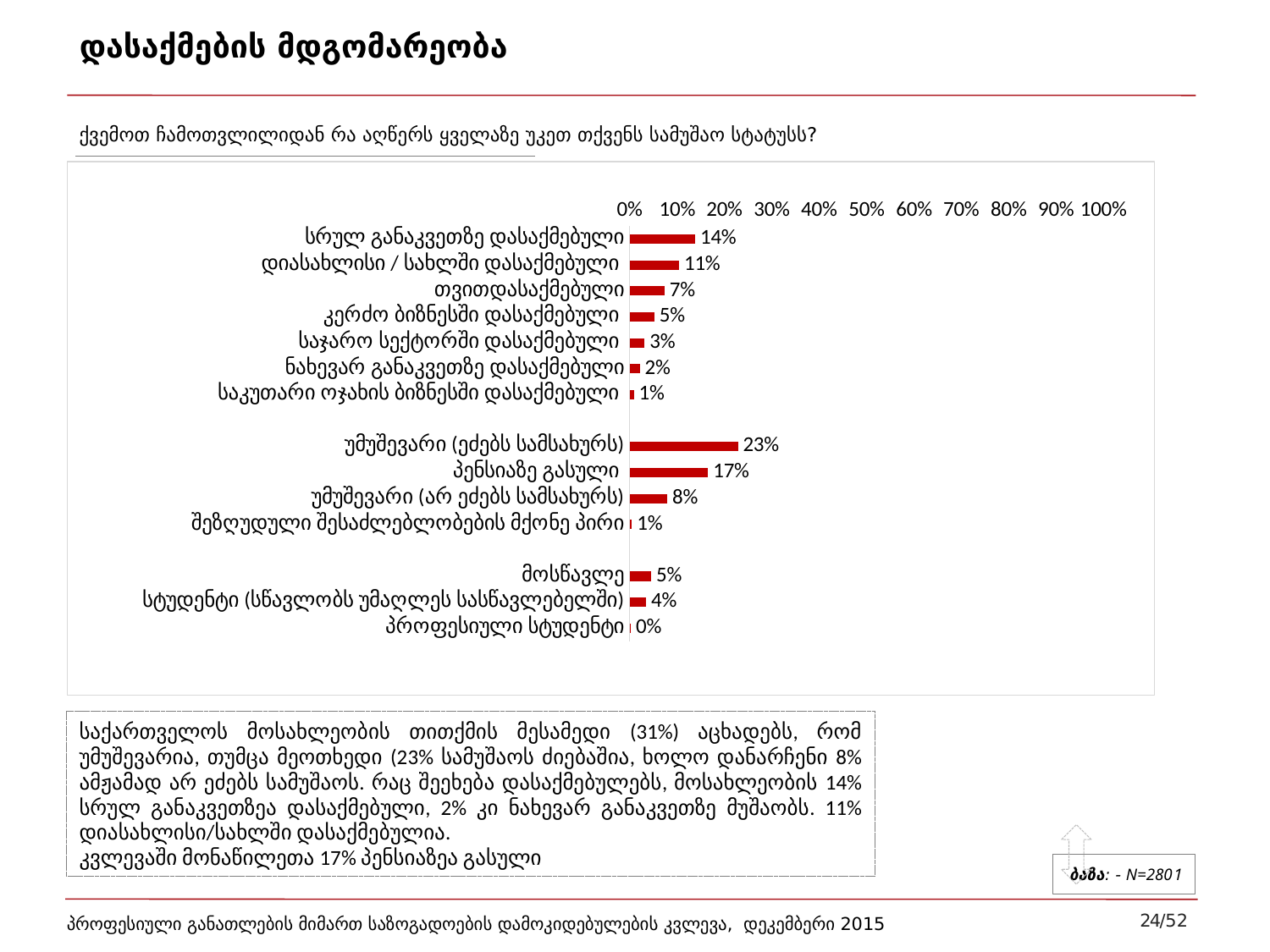
Is the value for პენსიაზე გასული greater or less than 20%? less Which category has the highest value? უმუშევარი (ეძებს სამსახურს) What is the difference between სრულ განაკვეთზე დასაქმებული and ნახევარ განაკვეთზე დასაქმებული? 12% Which is larger, დიასახლისი / სახლში დასაქმებული or კერძო ბიზნესში დასაქმებული? დიასახლისი / სახლში დასაქმებული What kind of chart is shown on the slide? bar chart What is the highest value shown on the percentage axis? 100% How many categories are shown in the chart? 14 What is the value for პენსიაზე გასული? 17% Which category has the lowest value? პროფესიული სტუდენტი What is the difference between უმუშევარი (ეძებს სამსახურს) and უმუშევარი (არ ეძებს სამსახურს)? 15% What is the value for თვითდასაქმებული? 7% What is the value for სრულ განაკვეთზე დასაქმებული? 14%